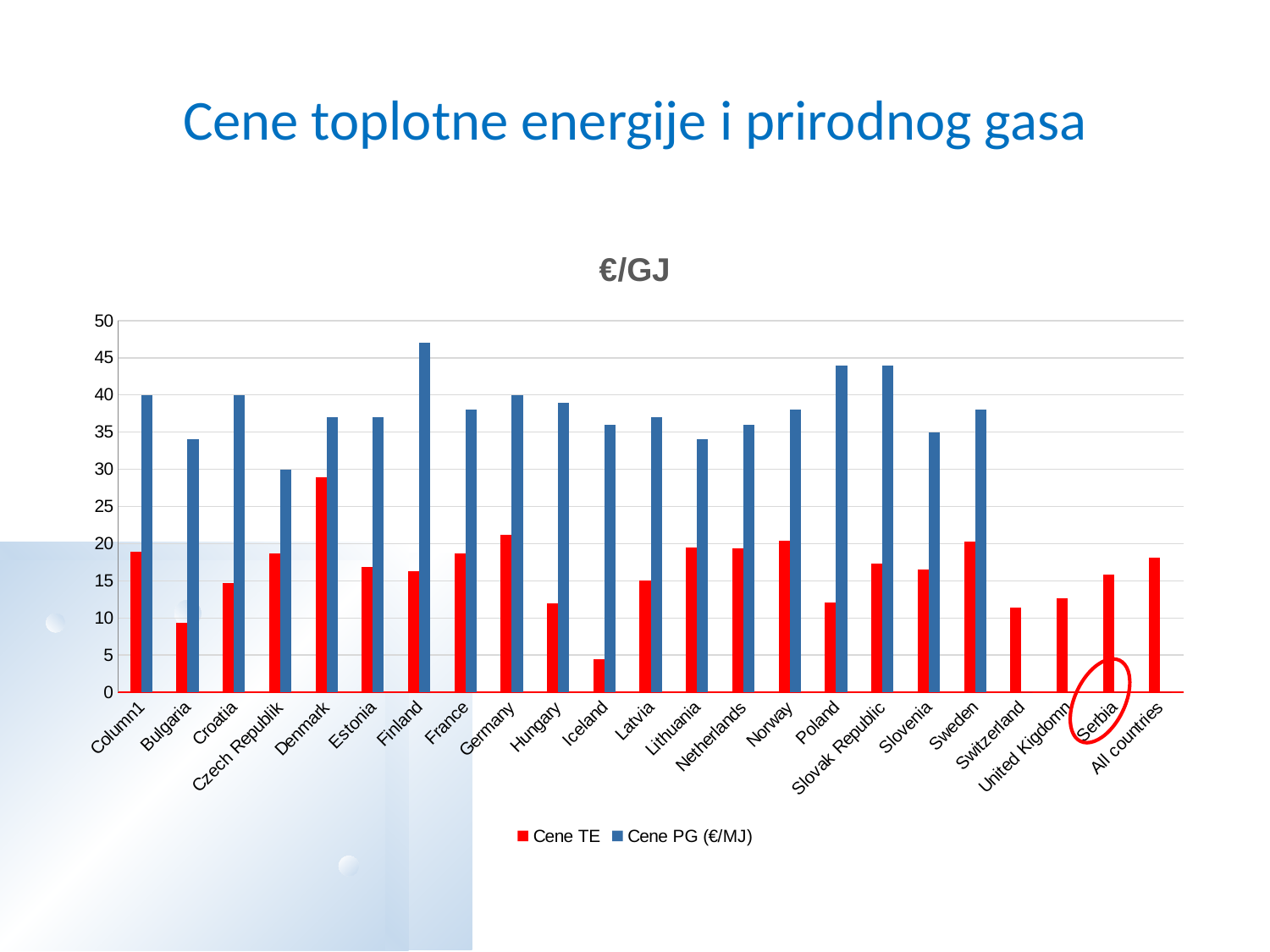
Is the Cene TE value for Denmark greater or less than 25? greater Is the Cene TE value for Iceland greater or less than 5? less Which category has the highest Cene TE value? Denmark Is the Cene PG (€/MJ) value for Finland greater or less than 45? greater What is the title of the chart? €/GJ Which is larger, the Cene TE value for Denmark or the Cene TE value for Bulgaria? Denmark How many categories are shown on the x axis? 23 What kind of chart is shown on the slide? bar chart Which category has the lowest Cene TE value? Iceland How many series does the legend list? 2 Which category has the highest Cene PG (€/MJ) value? Finland